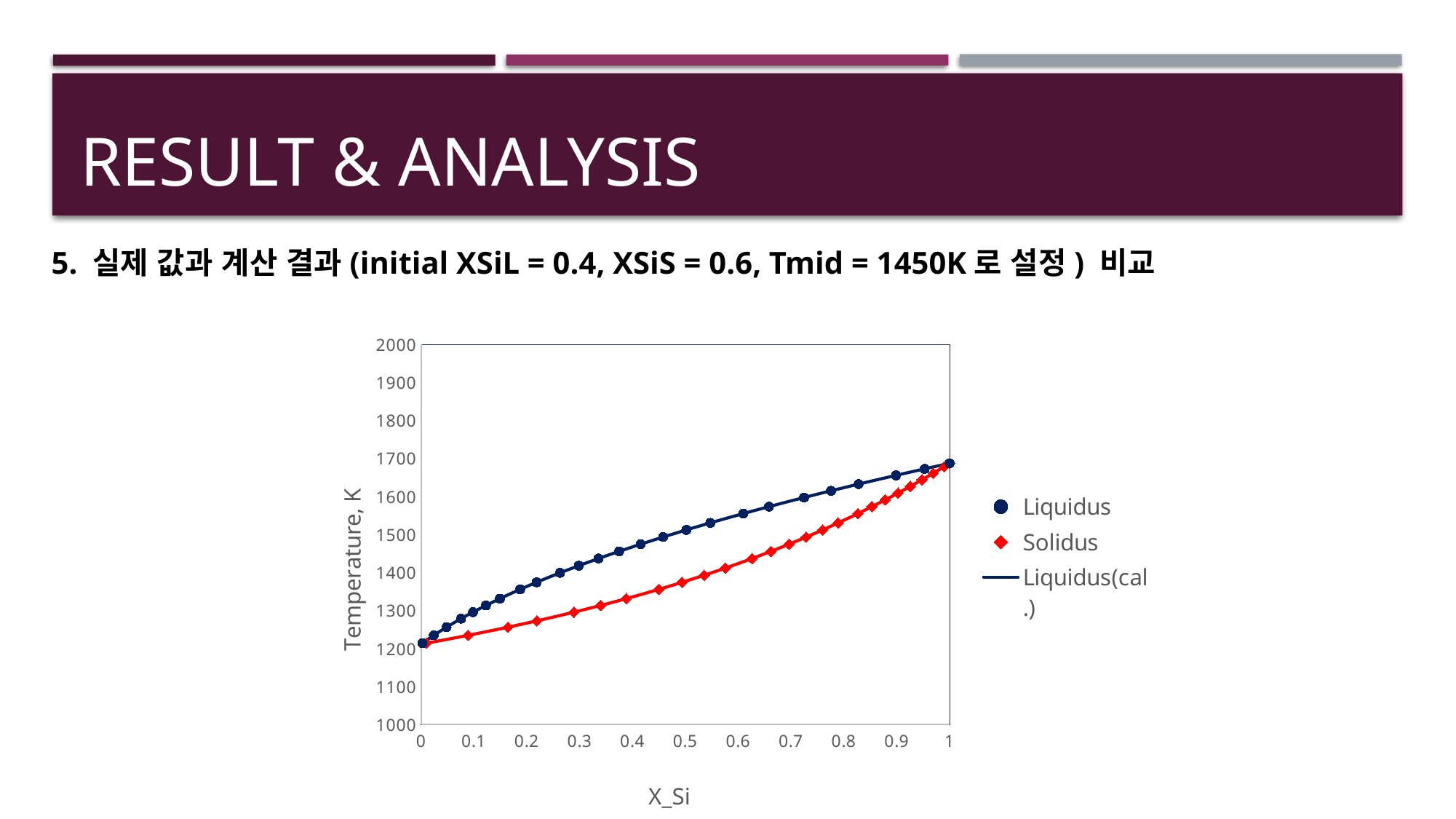
What are the series names listed in the legend? Liquidus, Solidus, Liquidus(cal.) Is the Liquidus value at X_Si = 0.8 greater or less than 1600? greater At X_Si = 0.5, which series has the higher temperature, Liquidus or Solidus? Liquidus Is the Solidus value at X_Si = 0.8 greater or less than 1600? less How many series does the legend list? 3 Do the Liquidus values rise or fall as X_Si increases from 0 to 1? rise Is the Solidus value at X_Si = 0.2 greater or less than 1300? less Do the Solidus values rise or fall as X_Si increases from 0 to 1? rise What kind of chart is shown on the slide? scatter chart with lines What is the title of the vertical axis? Temperature, K